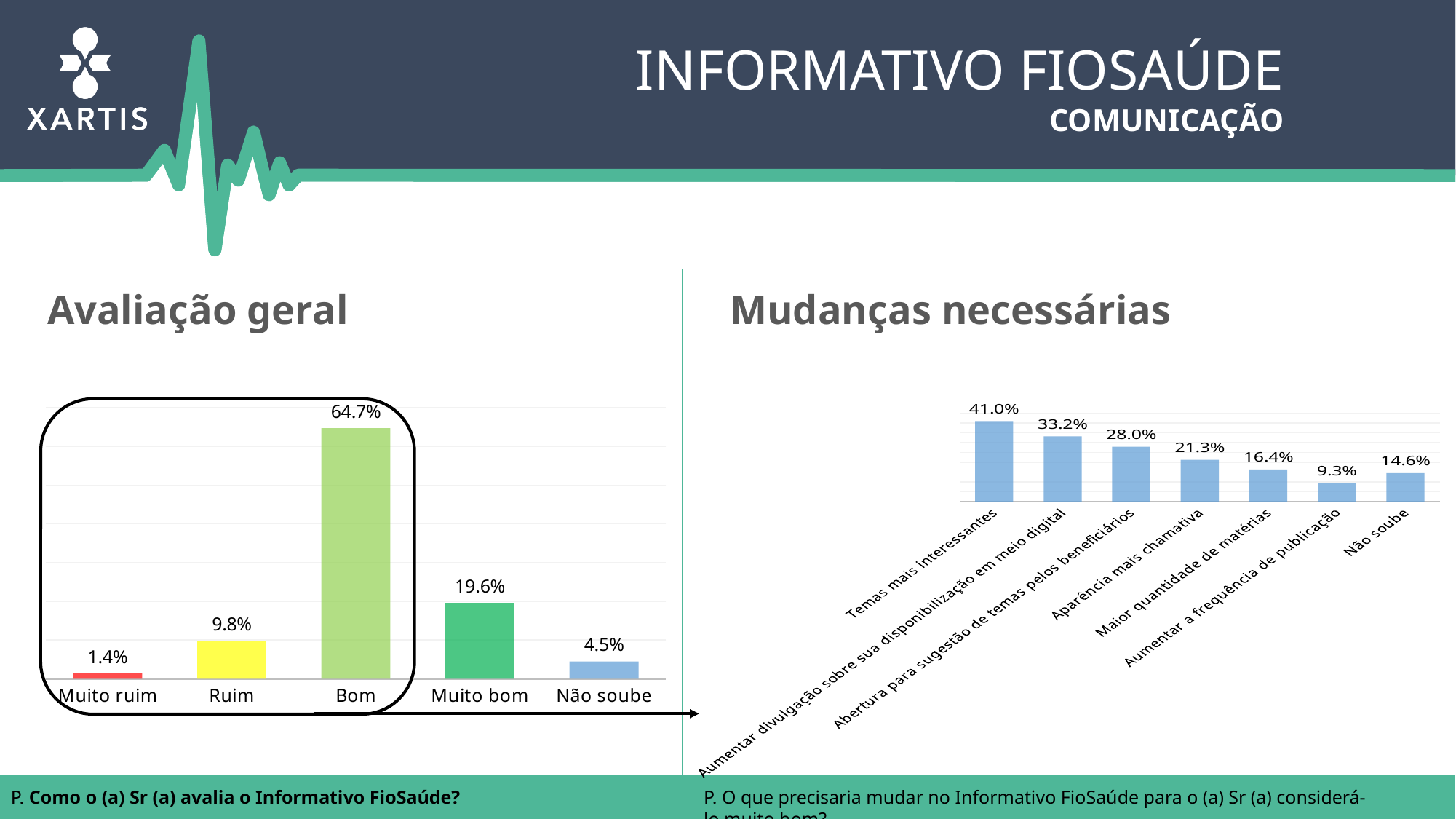
In the 'Avaliação geral' chart, what is the value for 'Muito bom'? 19.6% In the 'Mudanças necessárias' chart, how many categories are shown? 7 In the 'Mudanças necessárias' chart, what is the value for 'Aumentar a frequência de publicação'? 9.3% In the 'Avaliação geral' chart, which category has the lowest value? Muito ruim In the 'Mudanças necessárias' chart, which category has the highest value? Temas mais interessantes In the 'Avaliação geral' chart, what is the difference between 'Ruim' and 'Não soube'? 5.3% In the 'Mudanças necessárias' chart, what is the value for 'Temas mais interessantes'? 41.0% In the 'Avaliação geral' chart, what is the value for 'Bom'? 64.7% In the 'Mudanças necessárias' chart, which is larger: 'Maior quantidade de matérias' or 'Não soube'? Maior quantidade de matérias In the 'Mudanças necessárias' chart, what is the difference between 'Aparência mais chamativa' and 'Abertura para sugestão de temas pelos beneficiários'? 6.7% What kind of chart is the 'Avaliação geral' chart? Bar chart In the 'Avaliação geral' chart, how many categories are shown? 5